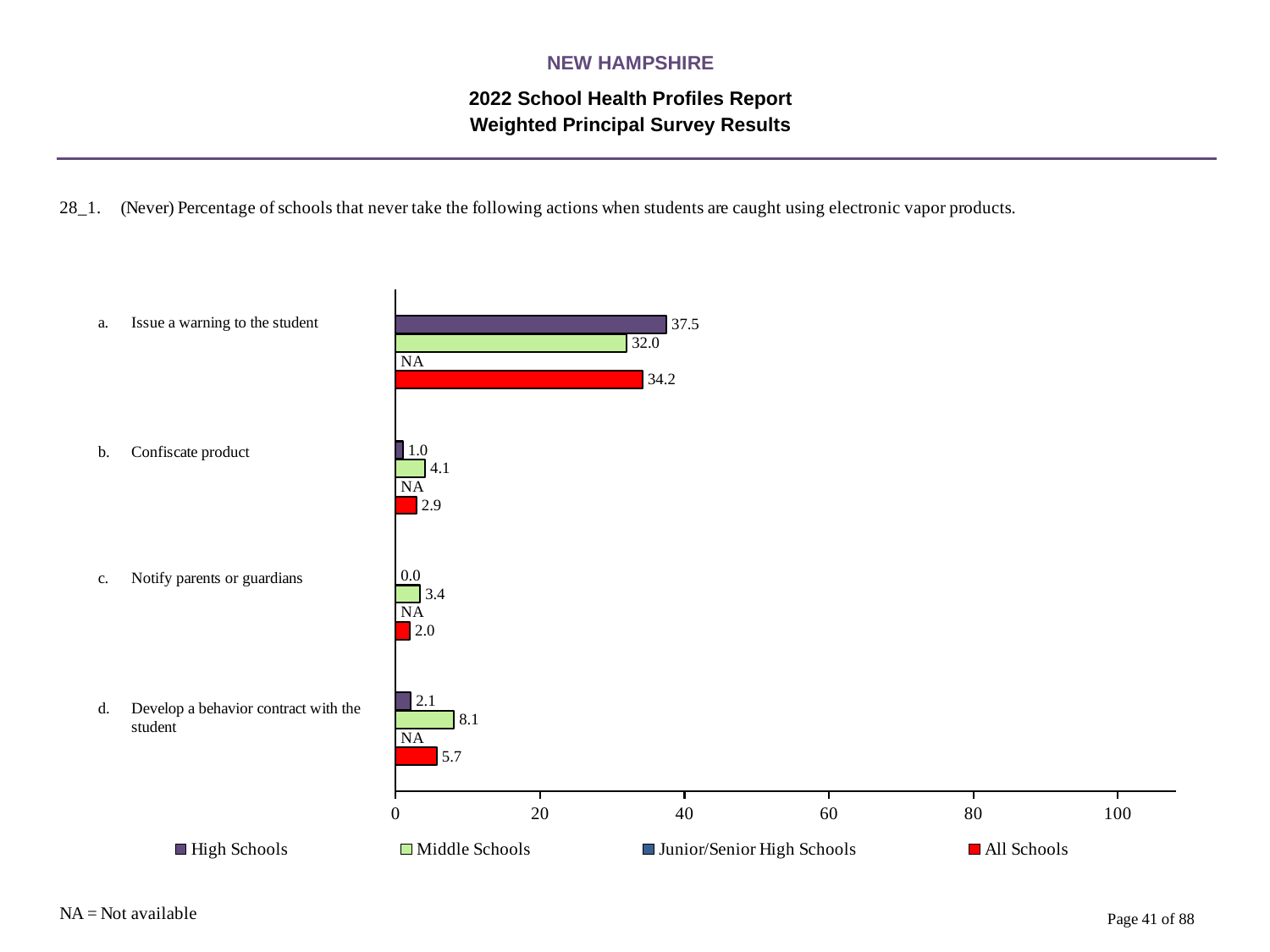
What is the Middle Schools value for 'Notify parents or guardians'? 3.4 How many actions (categories) are shown in the chart? 4 What is the High Schools value for 'Issue a warning to the student'? 37.5 How many series does the legend list? 4 Which action has the lowest High Schools value? Notify parents or guardians For 'Confiscate product', which is larger: the Middle Schools value or the All Schools value? Middle Schools What is the difference between the Middle Schools and High Schools values for 'Develop a behavior contract with the student'? 6.0 Which action has the highest All Schools value? Issue a warning to the student What is the Junior/Senior High Schools value for 'Confiscate product'? NA What is the All Schools value for 'Develop a behavior contract with the student'? 5.7 Is the High Schools value for 'Issue a warning to the student' greater or less than 20? greater What kind of chart is shown on the slide? bar chart